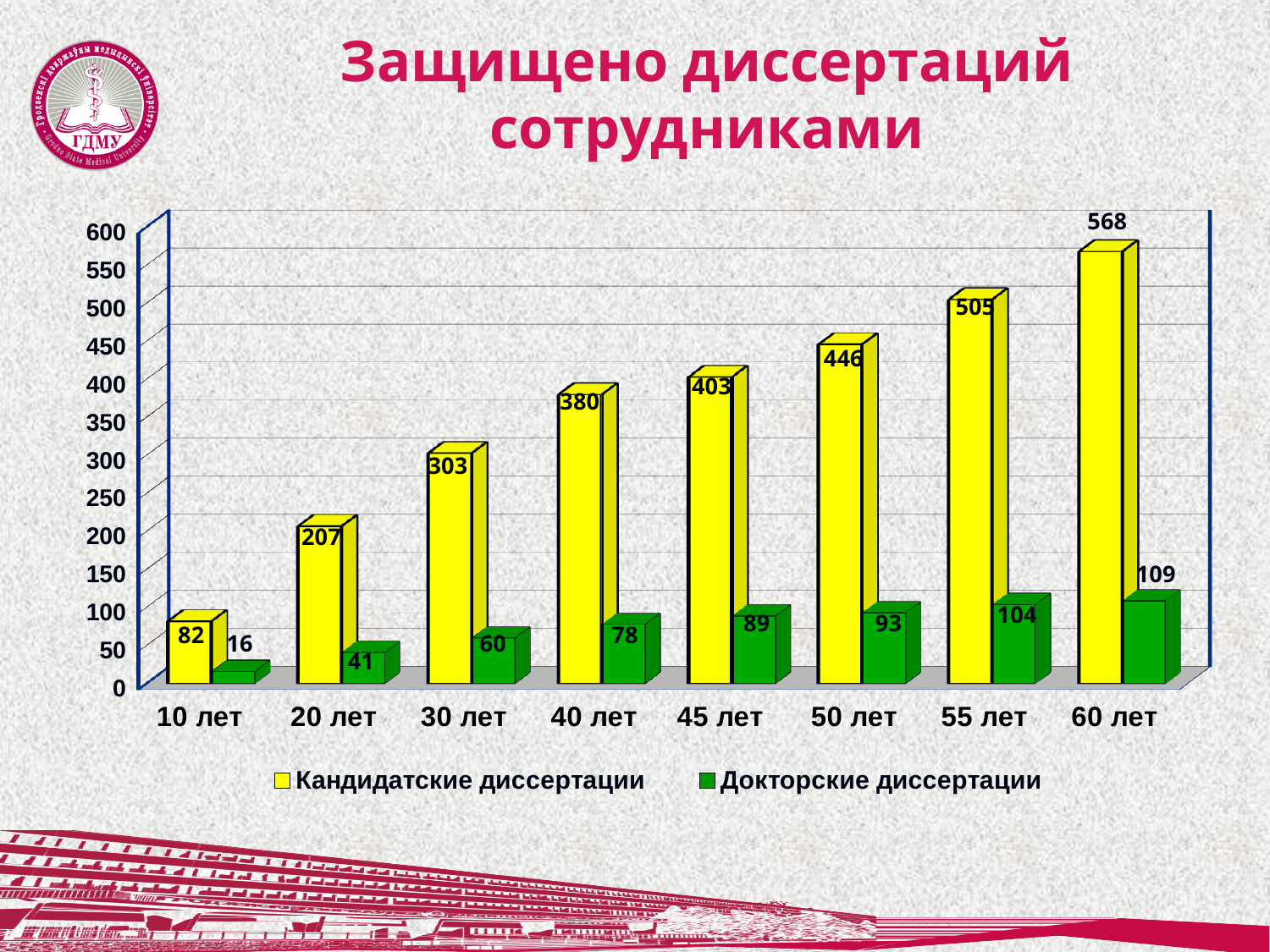
What is the value for Кандидатские диссертации at 30 лет? 303 Is the value for Кандидатские диссертации at 40 лет greater or less than 350? greater Which category has the lowest value for Докторские диссертации? 10 лет Which category has the highest value for Кандидатские диссертации? 60 лет What colour are the bars for Докторские диссертации? green Do the values for Кандидатские диссертации rise or fall from 10 лет to 60 лет? rise Which is larger: Докторские диссертации at 50 лет or at 40 лет? 50 лет How many categories are shown on the x axis? 8 How many series does the legend list? 2 What is the value for Докторские диссертации at 45 лет? 89 What kind of chart is shown on the slide? bar chart What is the difference between Кандидатские диссертации at 60 лет and at 55 лет? 63